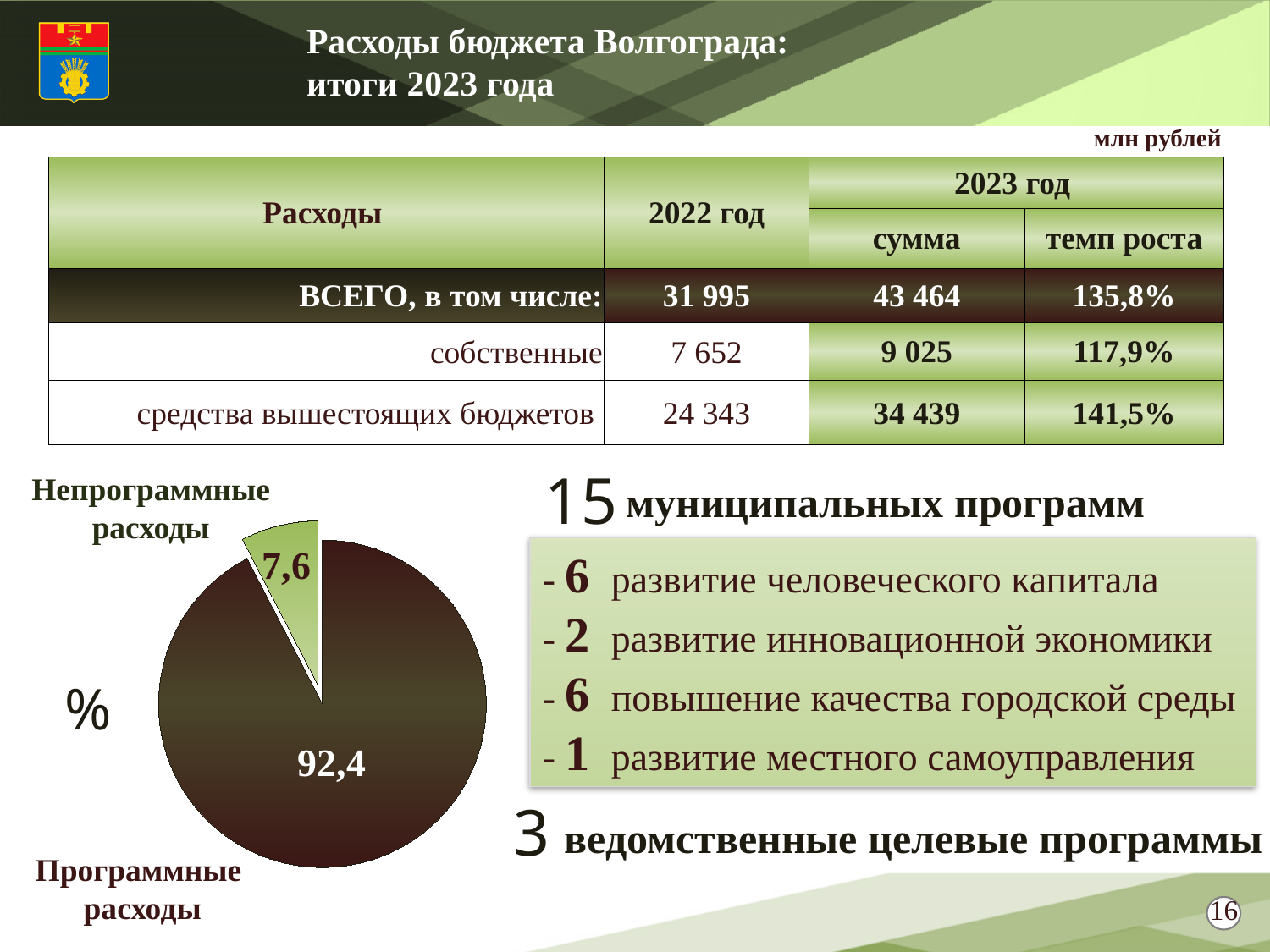
What colour is the Непрограммные расходы slice in the pie chart? light green What is the difference between the Программные расходы and Непрограммные расходы values in the pie chart? 84,8 What share of the pie does the Непрограммные расходы slice represent? 7,6% Which slice of the pie chart is the largest? Программные расходы Which is larger in the pie chart: Программные расходы or Непрограммные расходы? Программные расходы What is the value for Непрограммные расходы in the pie chart? 7,6 What is the value for Программные расходы in the pie chart? 92,4 What kind of chart is shown on the slide? pie chart Which slice of the pie chart is the smallest? Непрограммные расходы What unit is indicated next to the pie chart? % How many slices does the pie chart have? 2